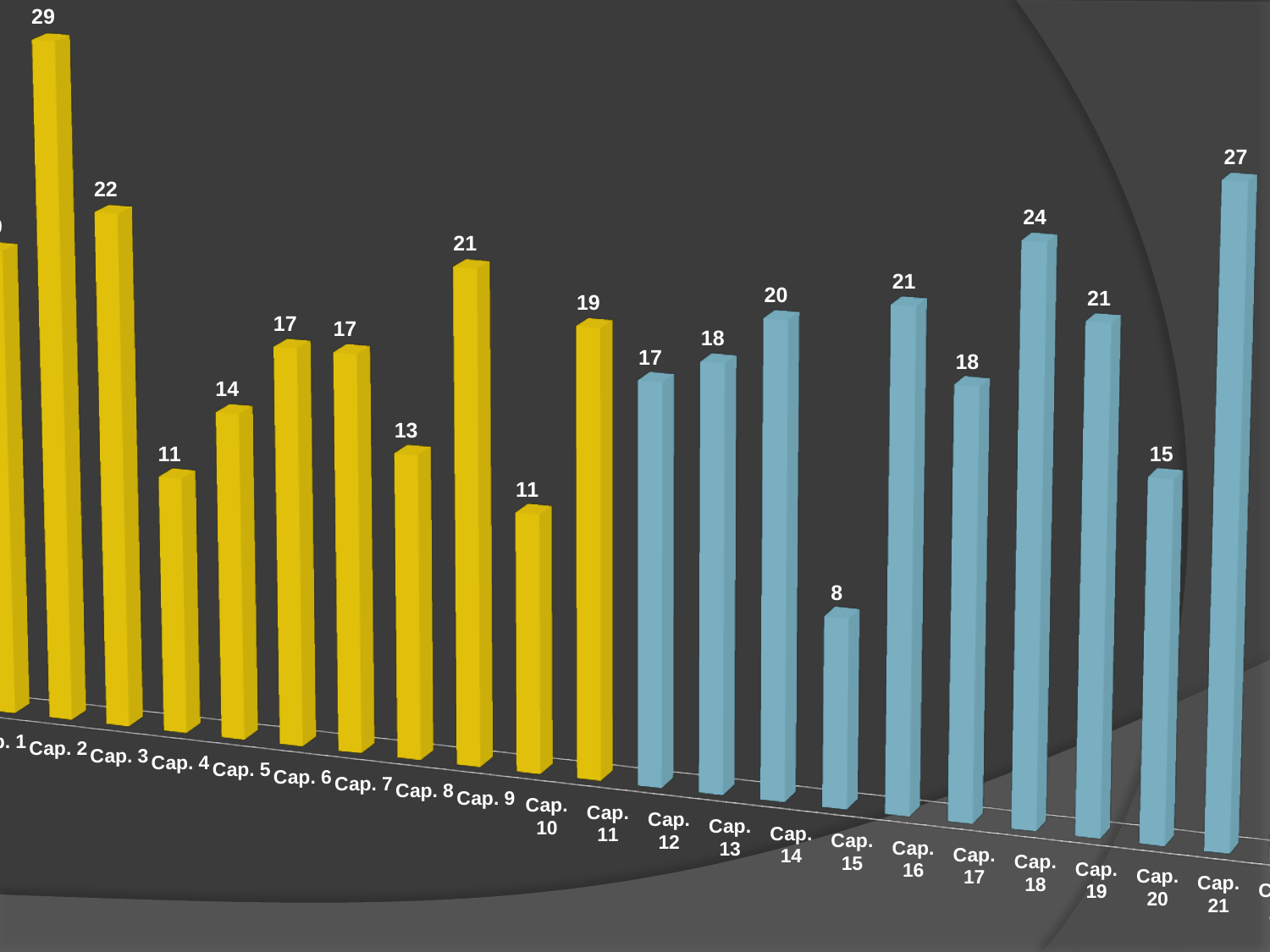
What colour are the bars for Cap. 12 through Cap. 21? Blue Which is larger, the value for Cap. 14 or the value for Cap. 13? Cap. 14 What is the difference between the values for Cap. 2 and Cap. 3? 7 Which of the blue bars has the highest value? Cap. 21 Which category has the lowest value among the bars shown? Cap. 15 What is the value for Cap. 15? 8 What is the difference between the values for Cap. 21 and Cap. 20? 12 What is the value for Cap. 2? 29 What is the value for Cap. 9? 21 What kind of chart is shown on the slide? Bar chart What is the value for Cap. 18? 24 What is the value for Cap. 21? 27